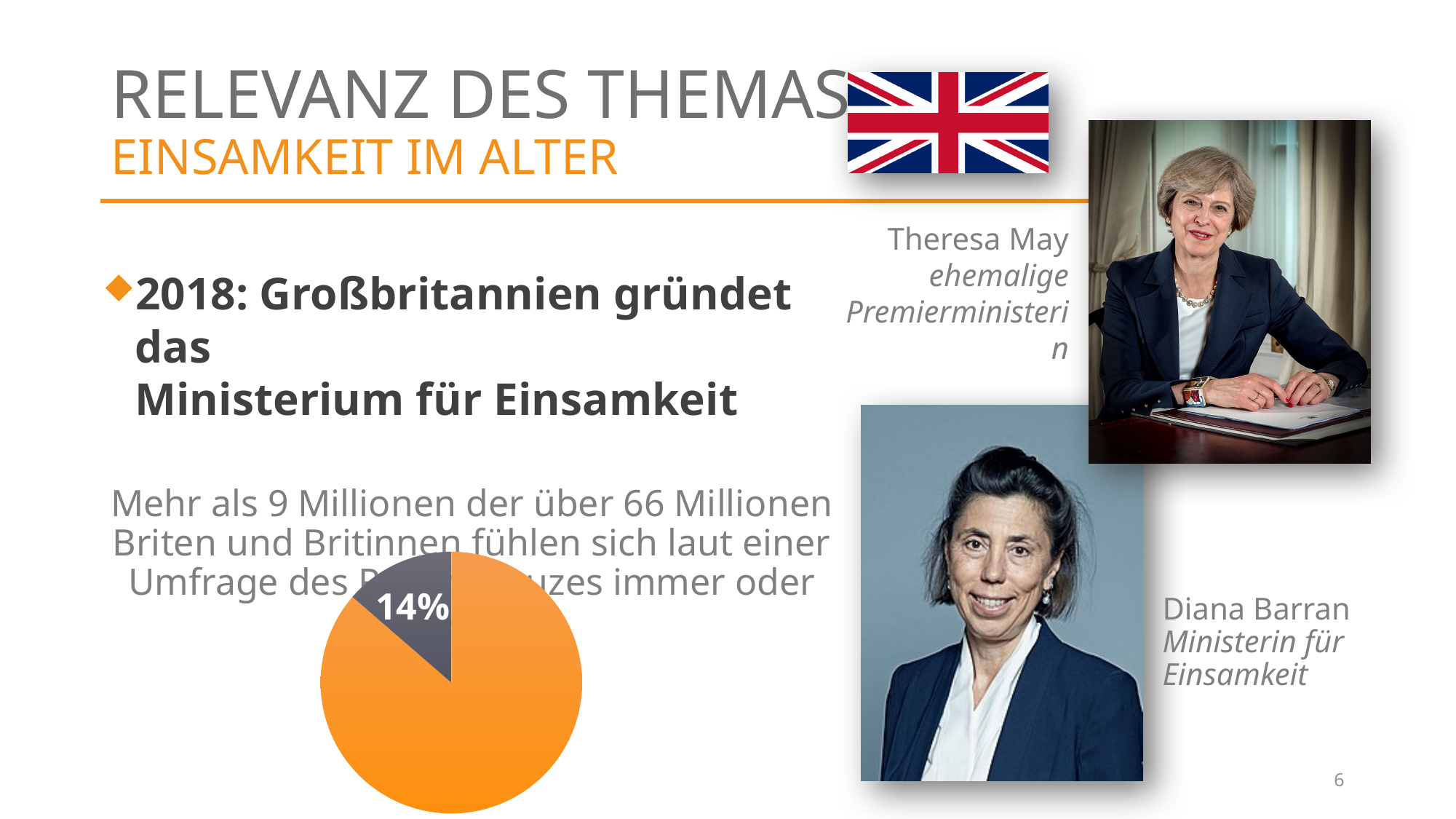
Which slice of the pie chart is larger, the orange one or the grey one? the orange one What percentage is printed on the grey slice of the pie chart? 14% What two colours are used for the slices of the pie chart? orange and grey What share of the pie does the grey slice represent? 14% How many slices of the pie chart carry a printed data label? 1 How many slices does the pie chart have? 2 Is the share of the grey slice greater or less than 50%? less Which colour slice takes up the largest part of the pie chart? orange Which colour slice is the smallest in the pie chart? grey What kind of chart is shown on the slide? pie chart